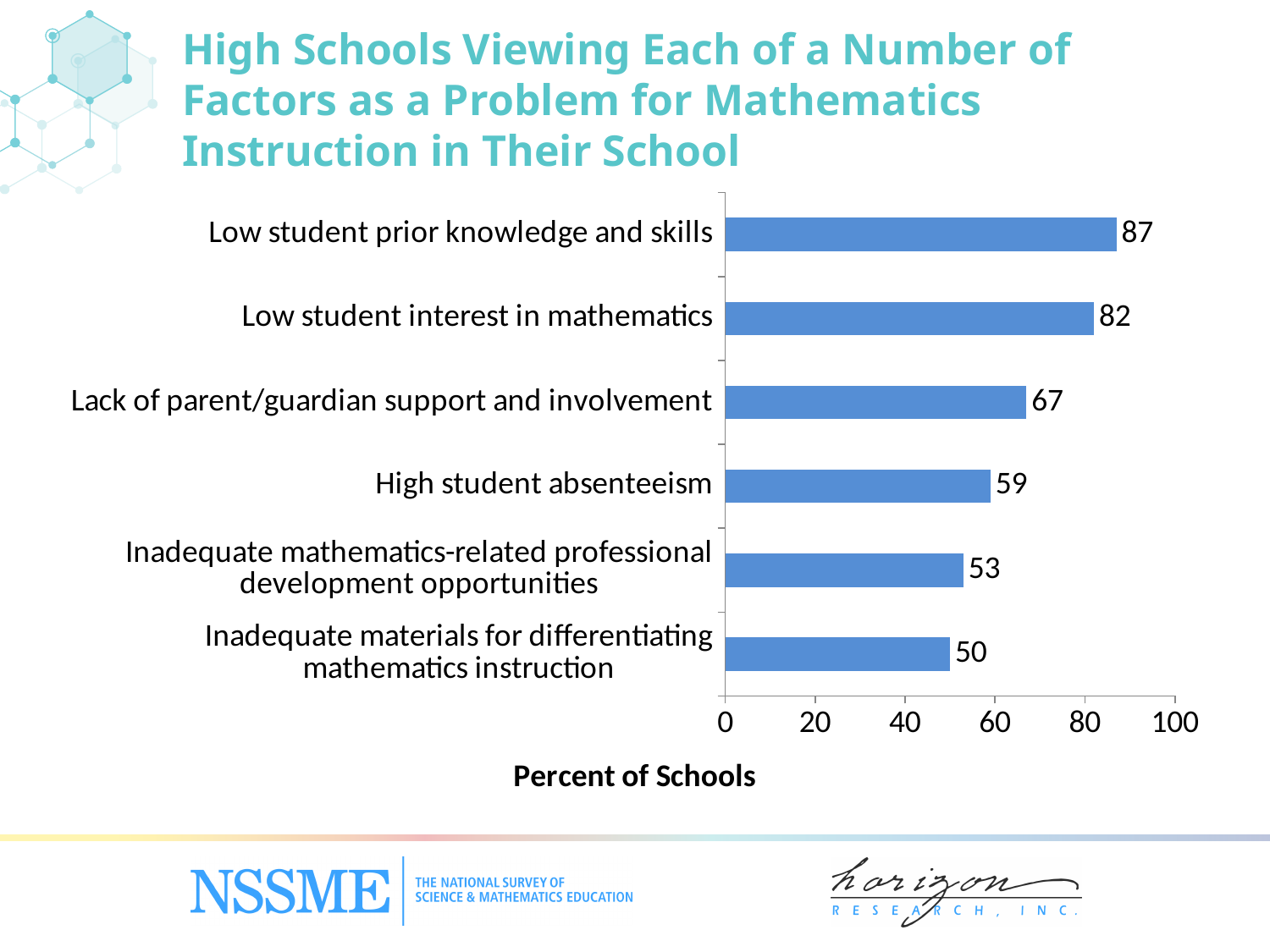
What is the value for inadequate materials for differentiating mathematics instruction? 50 What is the difference between the highest and lowest values in the chart? 37 Which factor has the highest percent of schools viewing it as a problem? Low student prior knowledge and skills What percent of high schools view low student prior knowledge and skills as a problem for mathematics instruction? 87 What is the value for high student absenteeism? 59 How many factors are shown in the chart? 6 Is the value for lack of parent/guardian support and involvement greater or less than 60? greater Which is larger: the value for high student absenteeism or the value for inadequate mathematics-related professional development opportunities? High student absenteeism What is the difference between the values for low student interest in mathematics and lack of parent/guardian support and involvement? 15 Which factor has the lowest percent of schools viewing it as a problem? Inadequate materials for differentiating mathematics instruction What kind of chart is shown on the slide? Bar chart What is the label of the horizontal axis? Percent of Schools